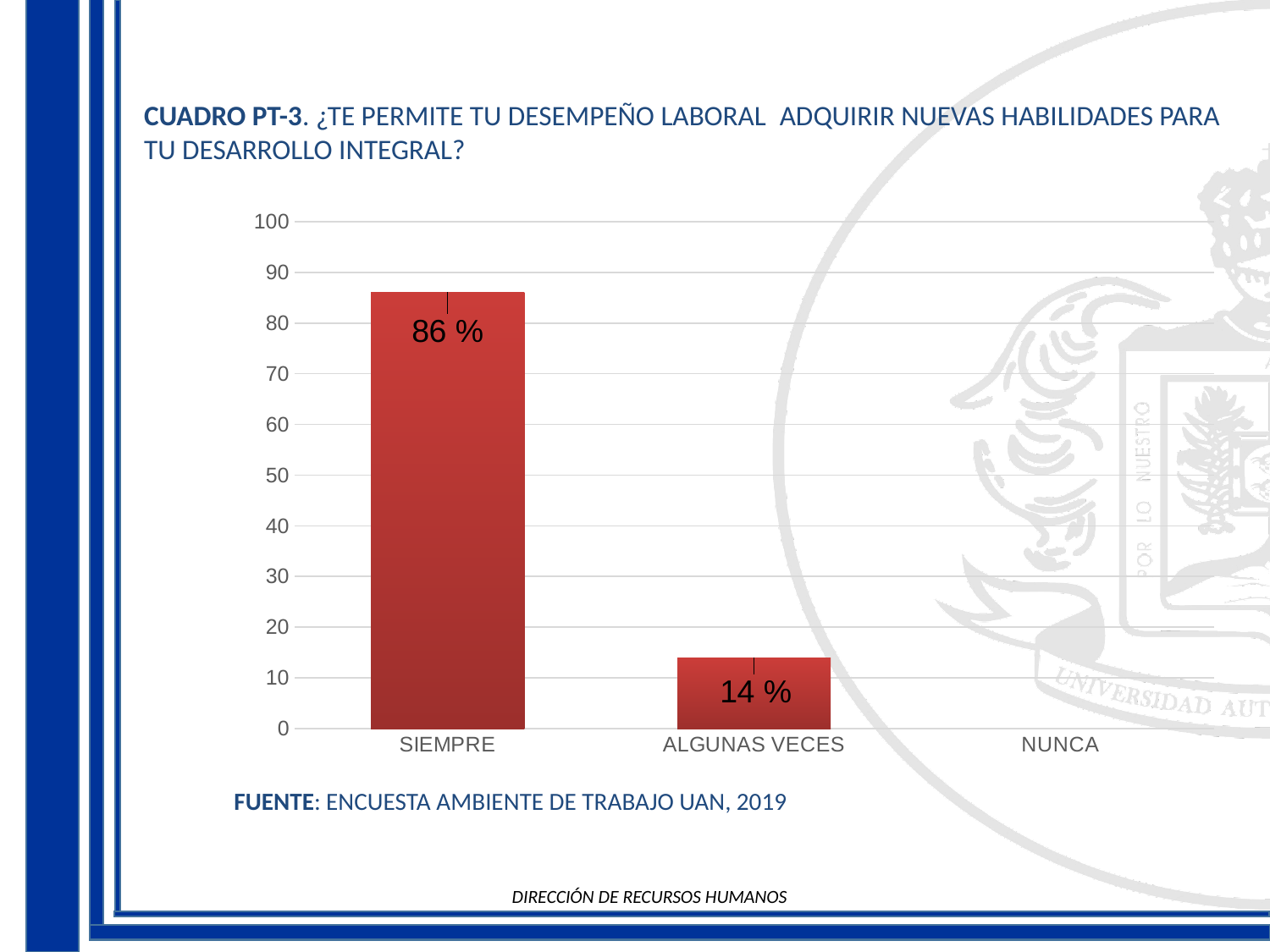
Is the value for ALGUNAS VECES greater or less than 20? less How many categories are shown on the x axis? 3 What kind of chart is shown on the slide? bar chart What is the difference between the values for SIEMPRE and ALGUNAS VECES? 72 % Which category has the highest value? SIEMPRE Which is larger, the value for SIEMPRE or the value for ALGUNAS VECES? SIEMPRE Is the value for SIEMPRE greater or less than 80? greater What is the value for ALGUNAS VECES? 14 % What is the label of the chart (cuadro) shown on the slide? CUADRO PT-3 What is the value for SIEMPRE? 86 % What is the source cited below the chart? ENCUESTA AMBIENTE DE TRABAJO UAN, 2019